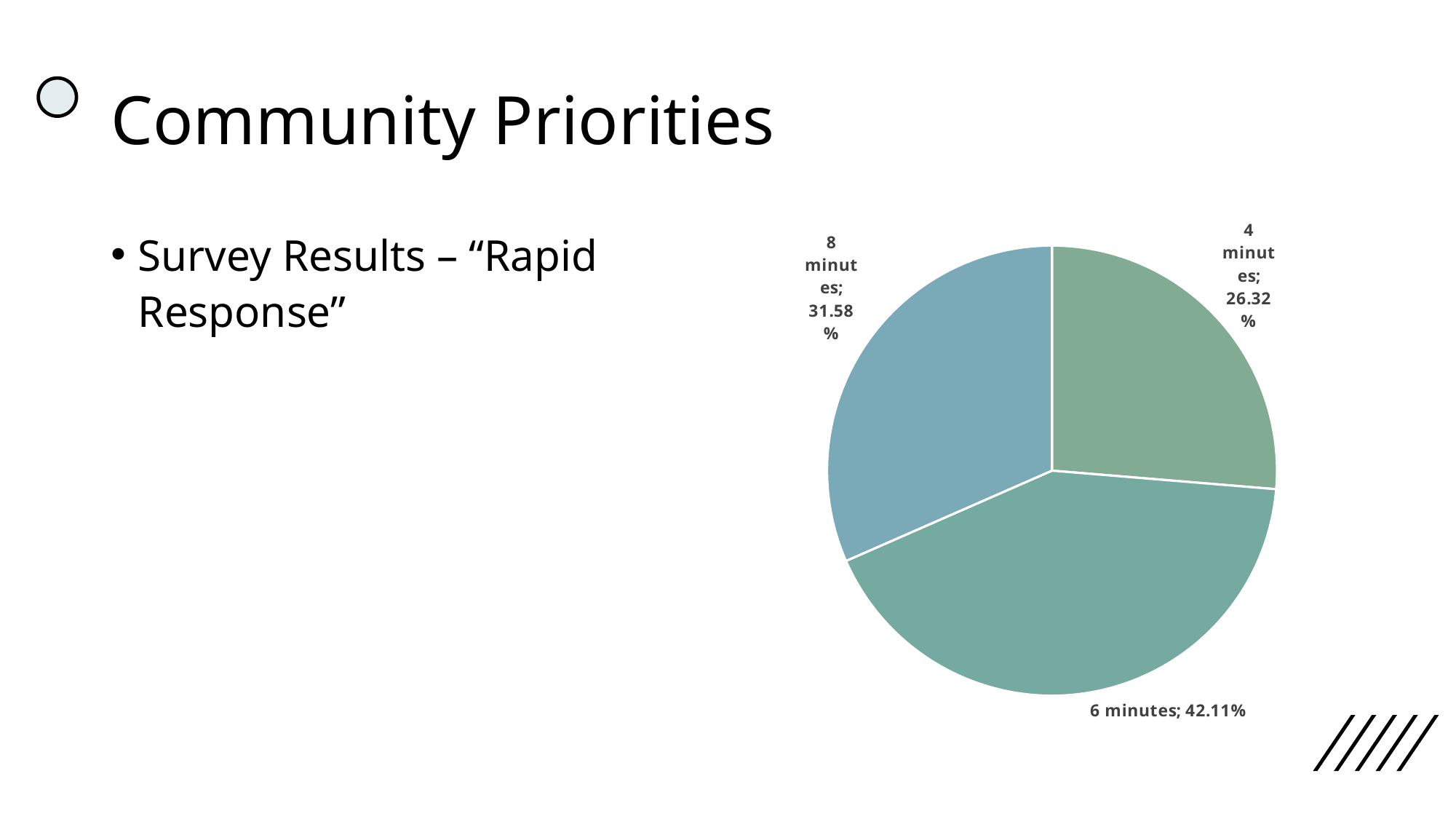
How many slices does the pie chart have? 3 Is the share for 6 minutes greater or less than 50%? less What survey topic does the bullet text say the chart shows results for? Rapid Response What share of the pie does the 4 minutes slice represent? 26.32% What kind of chart is shown on the slide? pie chart What share of the pie does the 6 minutes slice represent? 42.11% Which slice of the pie is the smallest? 4 minutes What is the difference in percentage points between the 6 minutes slice and the 8 minutes slice? 10.53 Which is larger, the 8 minutes slice or the 4 minutes slice? 8 minutes What is the difference in percentage points between the 8 minutes slice and the 4 minutes slice? 5.26 What share of the pie does the 8 minutes slice represent? 31.58% Which slice of the pie is the largest? 6 minutes